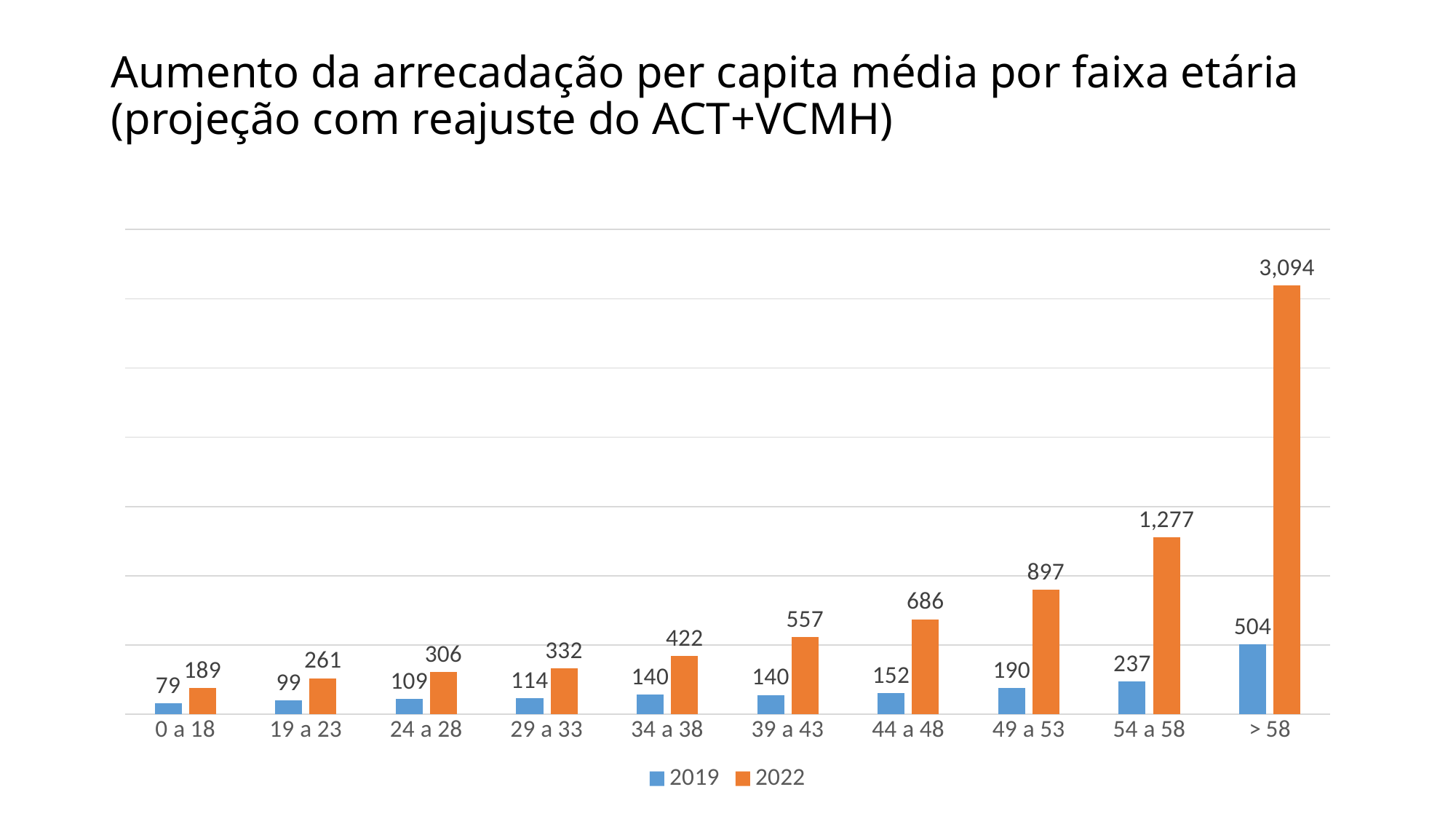
Which colour represents the 2019 series? Blue What is the 2019 value for the "34 a 38" age group? 140 Which age group has the lowest 2019 value? 0 a 18 What is the 2022 value for the "44 a 48" age group? 686 How many age groups are shown on the x axis? 10 Which is larger: the 2022 value for "49 a 53" or the 2019 value for "> 58"? 2022 value for 49 a 53 Which age group has the highest 2022 value? > 58 What is the difference between the 2022 and 2019 values for the "54 a 58" age group? 1,040 Do the 2022 values rise or fall as the age groups move from left to right? Rise What is the 2022 value for the "> 58" age group? 3,094 What kind of chart is shown on the slide? Bar chart How many series does the legend list? 2